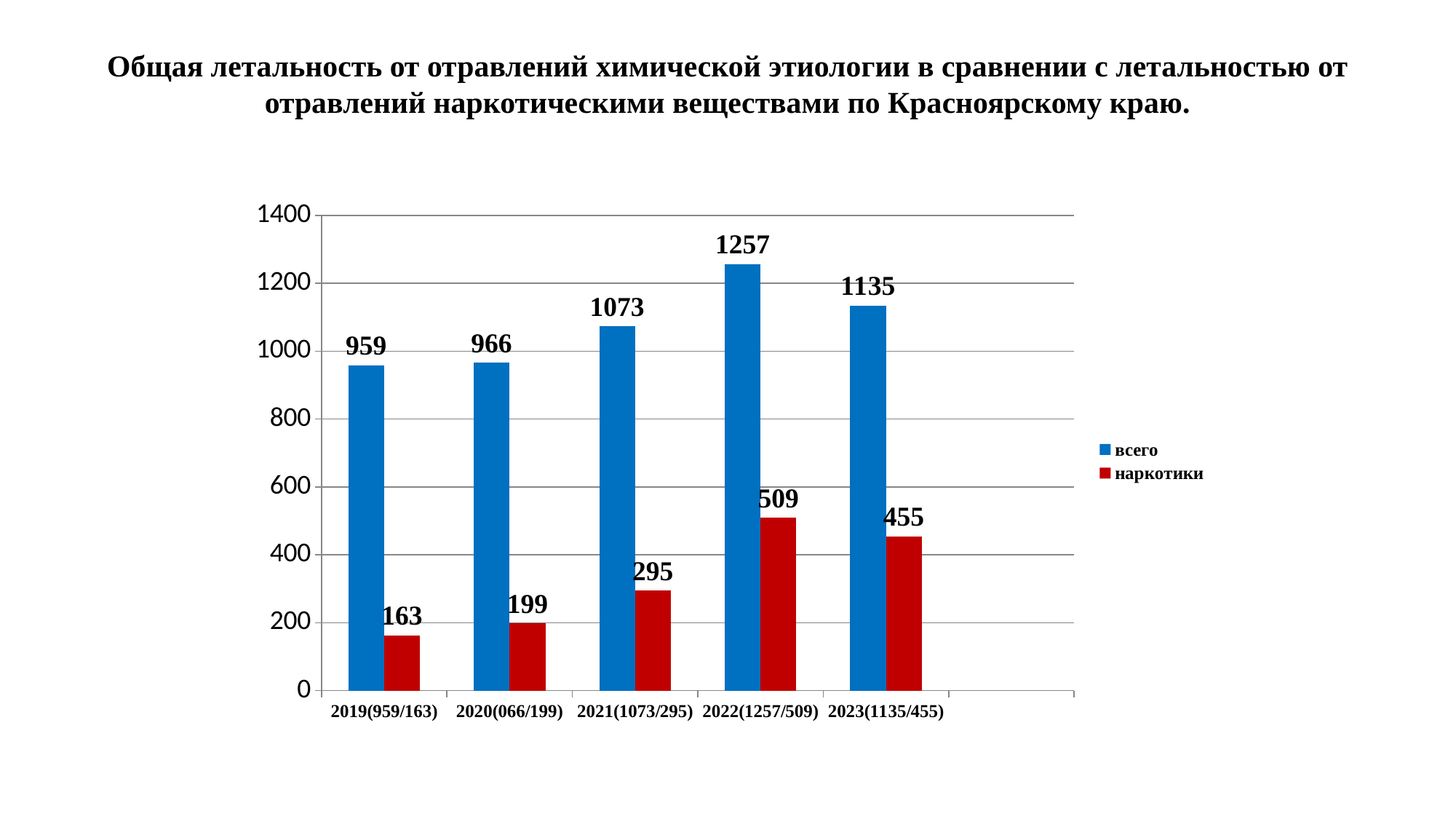
Is the "всего" value for 2021 greater or less than 1000? greater Does the "наркотики" series rise or fall from 2019 to 2022? rise What kind of chart is shown on the slide? bar chart What is the value of the "всего" series for 2019? 959 In which year is the "всего" series highest? 2022 Which is larger: the "наркотики" value for 2022 or for 2023? 2022 How many series does the legend list? 2 How many years (categories) are shown on the x axis? 5 In which year is the "наркотики" series lowest? 2019 What is the value of the "наркотики" series for 2021? 295 What is the difference between the "всего" and "наркотики" values for 2023? 680 What is the value of the "наркотики" series for 2022? 509